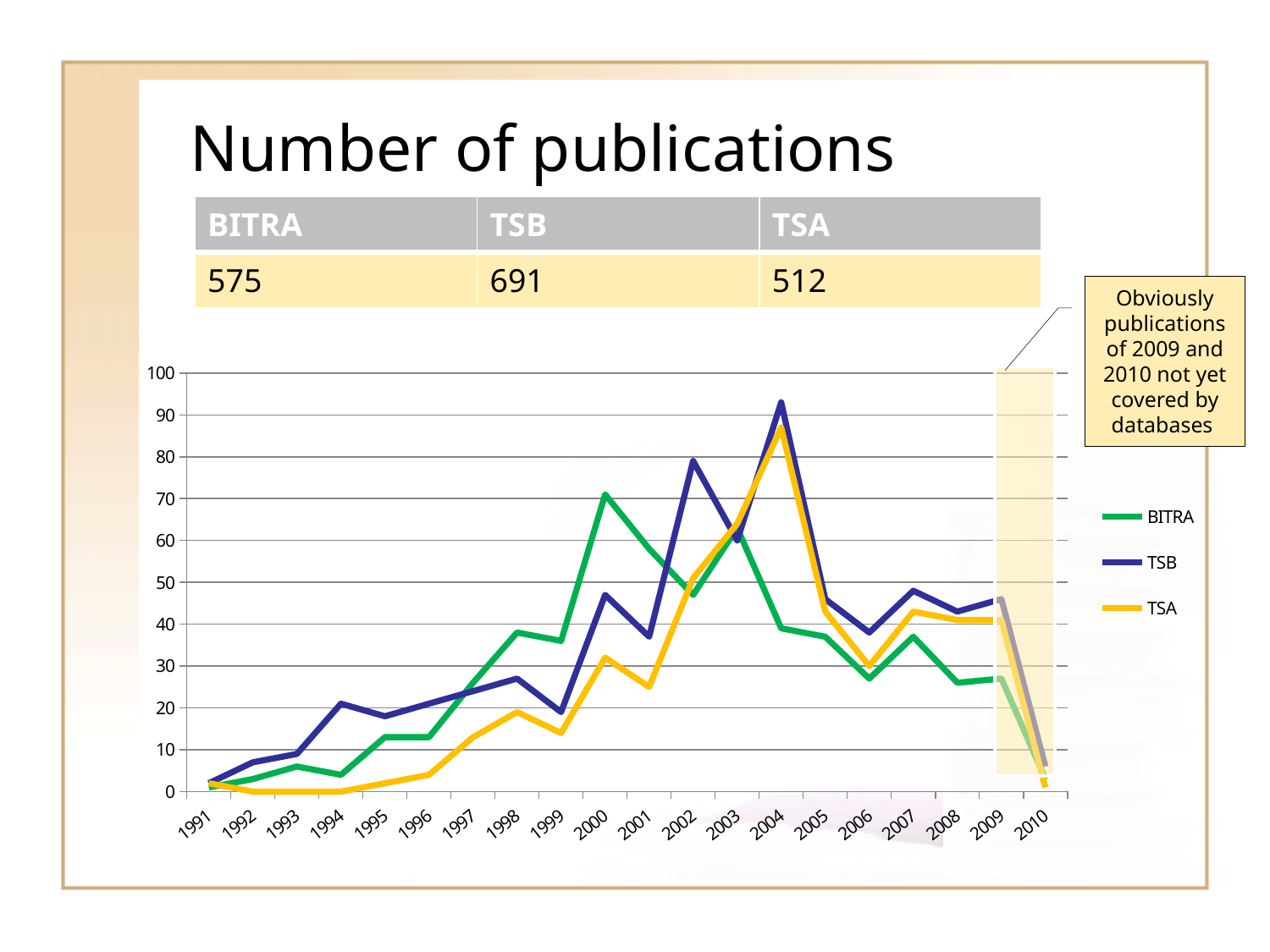
In which year does the TSA series reach its highest value? 2004 What colour is the TSA line in the chart? yellow In which year does the TSB series reach its highest value? 2004 How many series does the chart's legend list? 3 Is the value for TSB in 2004 greater or less than 80? greater In which year does the BITRA series reach its highest value? 2000 In 2002, which series has the higher value, TSB or BITRA? TSB How many years are plotted along the x axis of the chart? 20 What kind of chart is shown on the slide? line chart Is the value for TSA in 1994 greater or less than 10? less Does the TSB series rise or fall between 2004 and 2006? fall Is the value for BITRA in 2000 greater or less than 60? greater